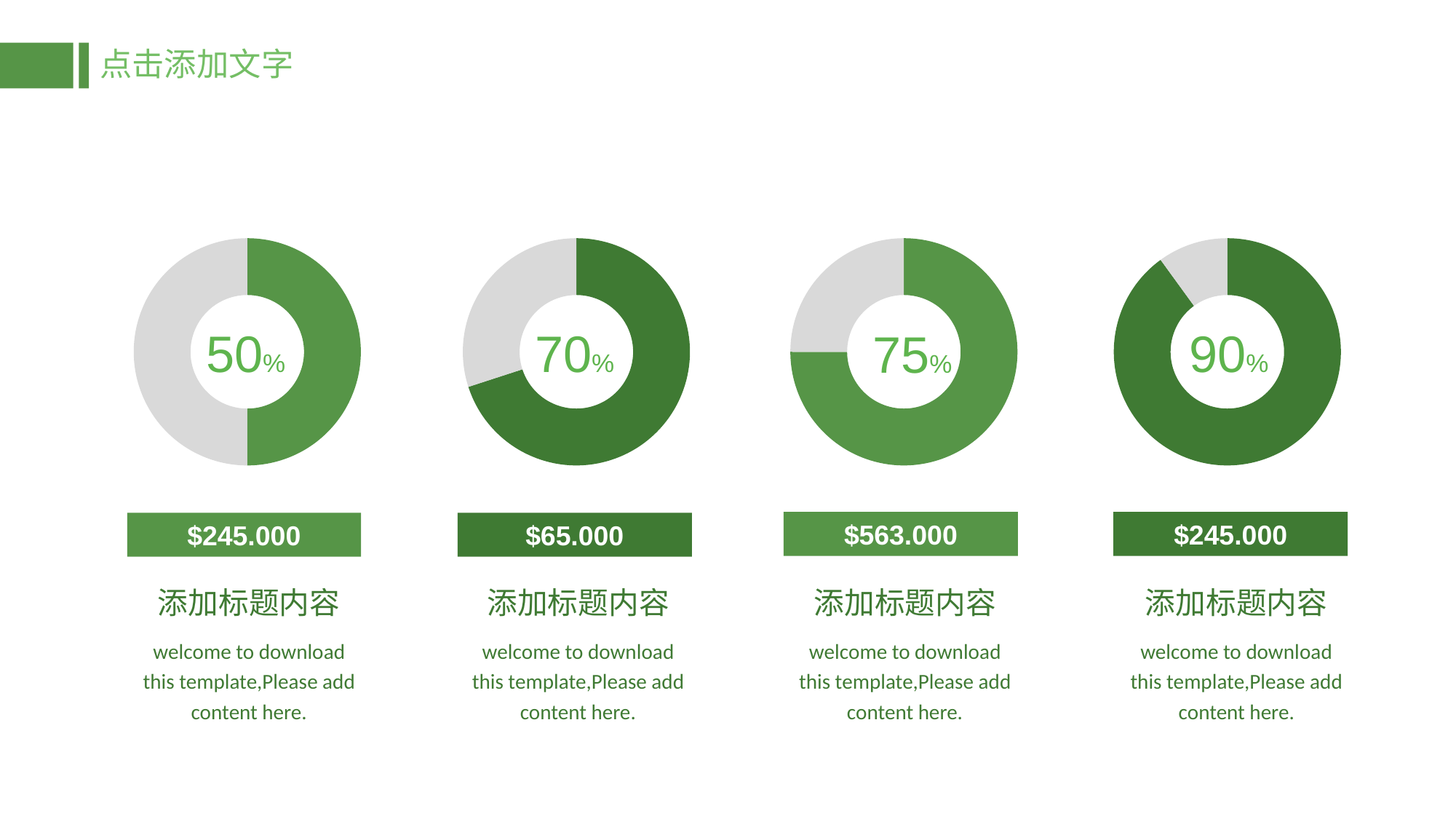
What dollar value is printed in the label below the second donut chart from the left? $65.000 Which donut chart shows the highest percentage? The rightmost one (90%) What dollar value is printed in the label below the third donut chart from the left? $563.000 What percentage is shown in the centre of the third donut chart from the left? 75% How many donut charts are on the slide? 4 Which donut chart shows the lowest percentage? The leftmost one (50%) What percentage is shown in the centre of the rightmost donut chart? 90% What is the difference between the percentage in the rightmost donut chart and the percentage in the leftmost donut chart? 40% What kind of chart is used to display the percentages on the slide? Donut chart What percentage is shown in the centre of the second donut chart from the left? 70% Which is larger, the percentage in the second donut chart or the percentage in the third donut chart? The third donut chart (75%) What percentage is shown in the centre of the leftmost donut chart? 50%